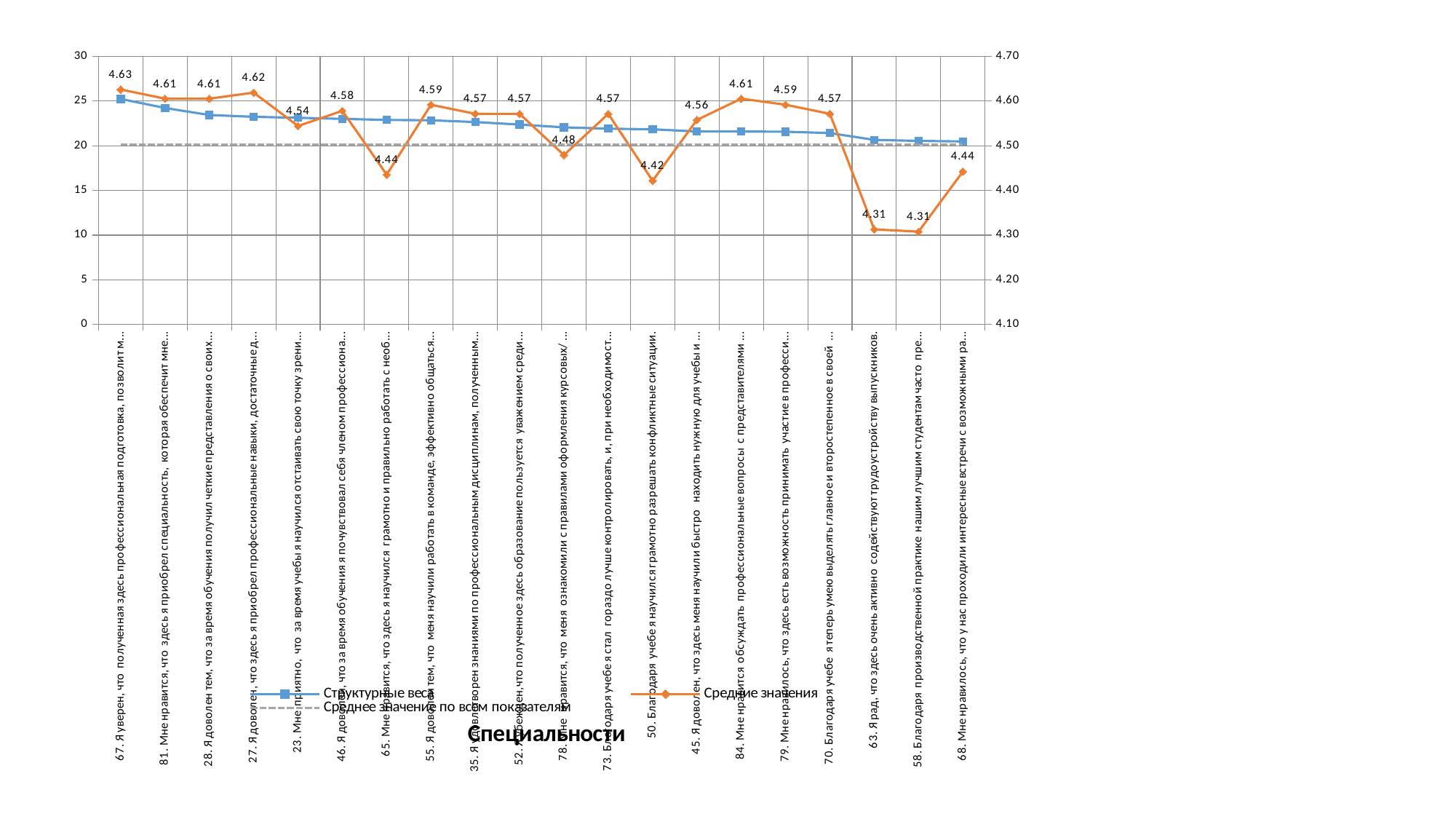
Which statement has the highest 'Средние значения' value? 67 What is the difference between the 'Средние значения' values for statement 67 and statement 63? 0.32 What is the value of the 'Средние значения' series for statement 67? 4.63 Is the 'Структурные веса' value for statement 67 greater or less than 20? greater Which has the larger 'Средние значения' value, statement 65 or statement 55? 55 How many categories (statements) are plotted along the x axis? 20 What is the lowest value shown for the 'Средние значения' series? 4.31 Do the 'Структурные веса' values rise or fall from left to right along the x axis? fall How many entries does the legend list? 3 What is the value of the 'Средние значения' series for statement 50? 4.42 What kind of chart is shown on the slide? line chart What is the title of the x axis? Специальности